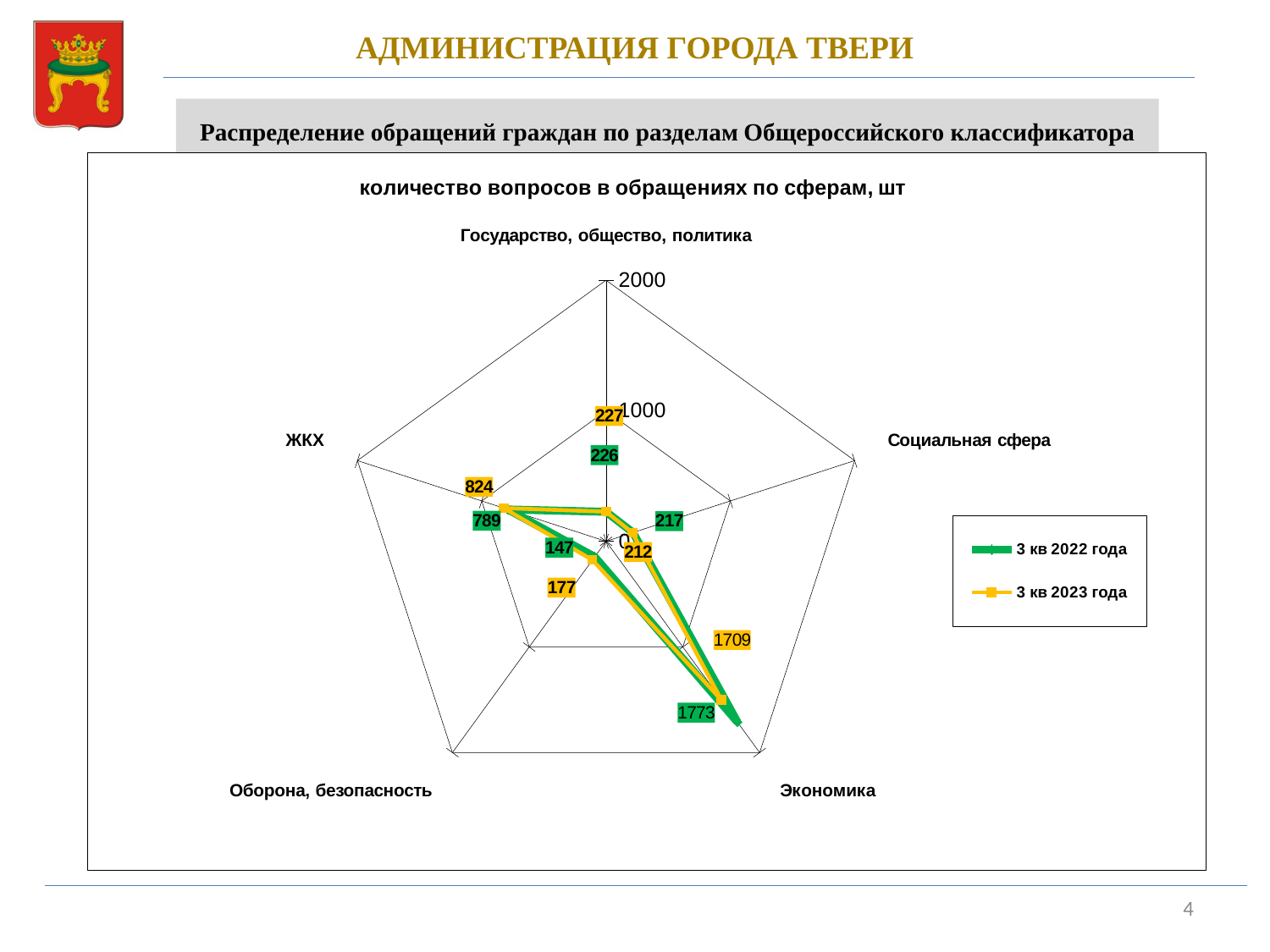
How many categories are shown on the chart? 5 What is the value for Социальная сфера in the 3 кв 2023 года series? 212 What is the value for Экономика in the 3 кв 2022 года series? 1773 What is the difference between the 3 кв 2023 года and 3 кв 2022 года values for ЖКХ? 35 What kind of chart is shown on the slide? Radar chart What is the value for ЖКХ in the 3 кв 2023 года series? 824 What is the difference between the 3 кв 2022 года and 3 кв 2023 года values for Экономика? 64 Which is larger for Оборона, безопасность: the 3 кв 2022 года value or the 3 кв 2023 года value? 3 кв 2023 года What is the value for Оборона, безопасность in the 3 кв 2022 года series? 147 Which category has the highest value in the 3 кв 2023 года series? Экономика Which category has the lowest value in the 3 кв 2022 года series? Оборона, безопасность How many series does the legend list? 2